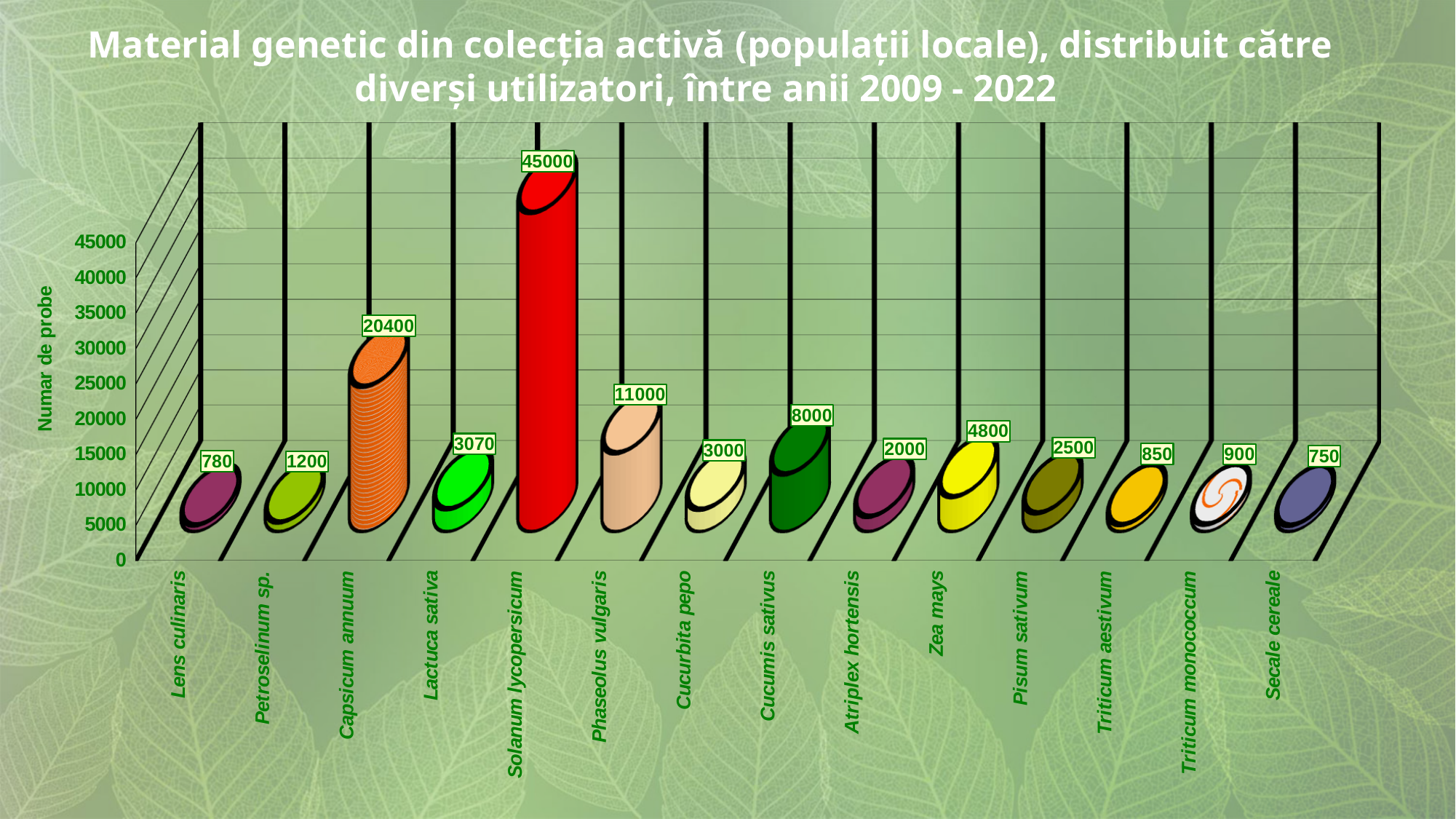
What is the value for Capsicum annuum? 20400 What kind of chart is this? bar chart What is the value for Triticum monococcum? 900 How many categories are shown on the x axis? 14 What is the value for Phaseolus vulgaris? 11000 Which category has the highest value? Solanum lycopersicum Which is larger, the value for Lactuca sativa or the value for Cucurbita pepo? Lactuca sativa What is the label of the vertical axis? Numar de probe What is the difference between the values for Cucumis sativus and Zea mays? 3200 What is the difference between the values for Solanum lycopersicum and Capsicum annuum? 24600 What is the value for Solanum lycopersicum? 45000 Which category has the lowest value? Secale cereale